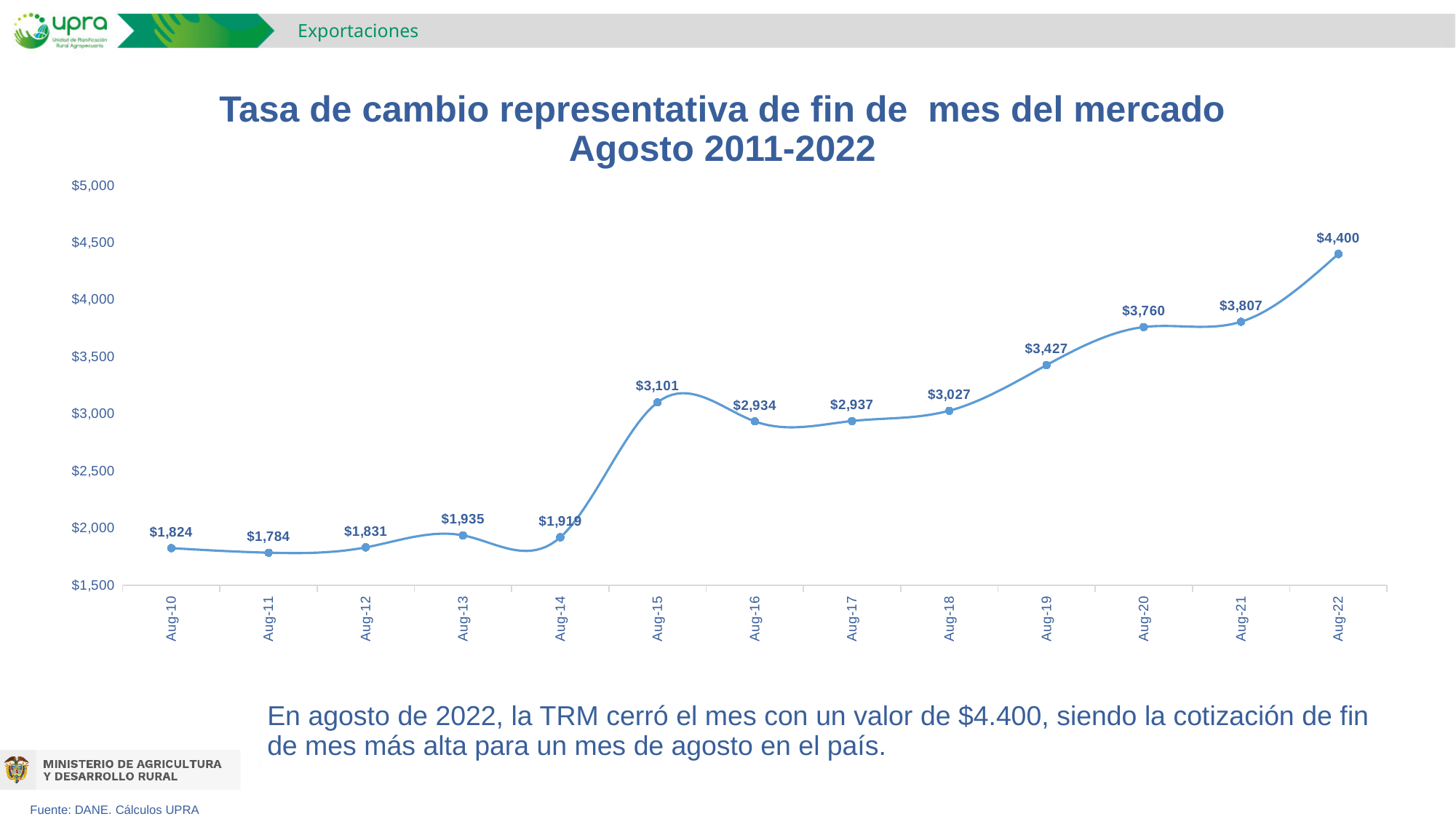
Is the value for Aug-19 greater or less than $3,500? less What is the difference between the values for Aug-22 and Aug-21? $593 What is the title of the chart? Tasa de cambio representativa de fin de mes del mercado Agosto 2011-2022 What type of chart is shown on the slide? line chart Which is larger, the value for Aug-16 or the value for Aug-18? Aug-18 What is the difference between the values for Aug-15 and Aug-14? $1,182 How many data points are plotted on the chart? 13 What is the value for Aug-11? $1,784 Which month has the highest value? Aug-22 Which month has the lowest value? Aug-11 What is the value for Aug-15? $3,101 What is the value for Aug-22? $4,400